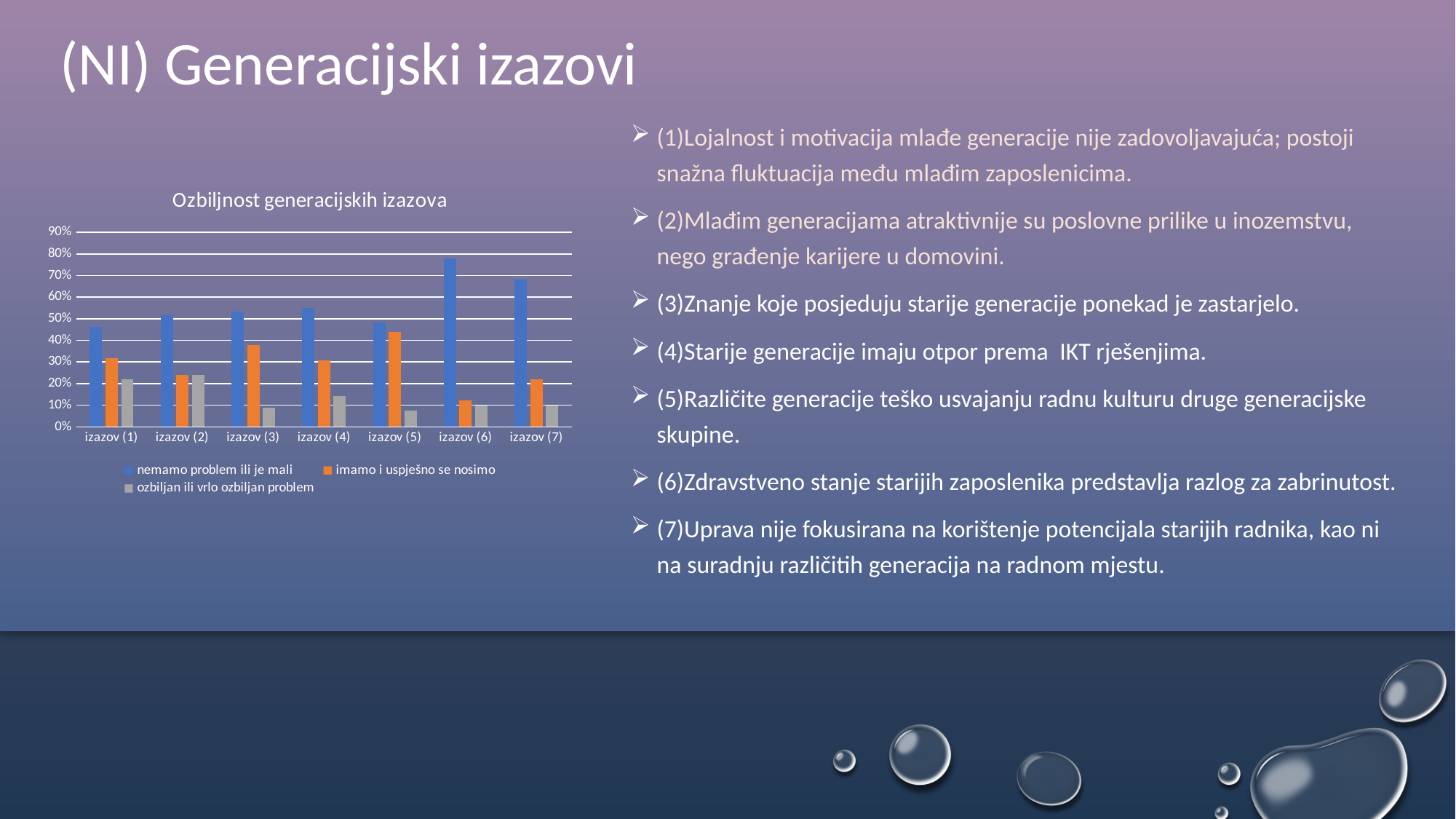
Is the value for 'ozbiljan ili vrlo ozbiljan problem' at izazov (3) greater or less than 20%? less Which series is shown in orange in the chart's legend? imamo i uspješno se nosimo How many series does the chart's legend list? 3 What is the title of the chart? Ozbiljnost generacijskih izazova Which category has the highest value for the series 'imamo i uspješno se nosimo'? izazov (5) Which category has the lowest value for the series 'nemamo problem ili je mali'? izazov (1) Which category has the highest value for the series 'nemamo problem ili je mali'? izazov (6) What kind of chart is shown on the slide? bar chart For izazov (7), which series has the larger value: 'nemamo problem ili je mali' or 'imamo i uspješno se nosimo'? nemamo problem ili je mali Is the value for 'imamo i uspješno se nosimo' at izazov (5) greater or less than 40%? greater How many categories (izazovi) are shown on the x axis of the chart? 7 Is the value for 'nemamo problem ili je mali' at izazov (6) greater or less than 70%? greater